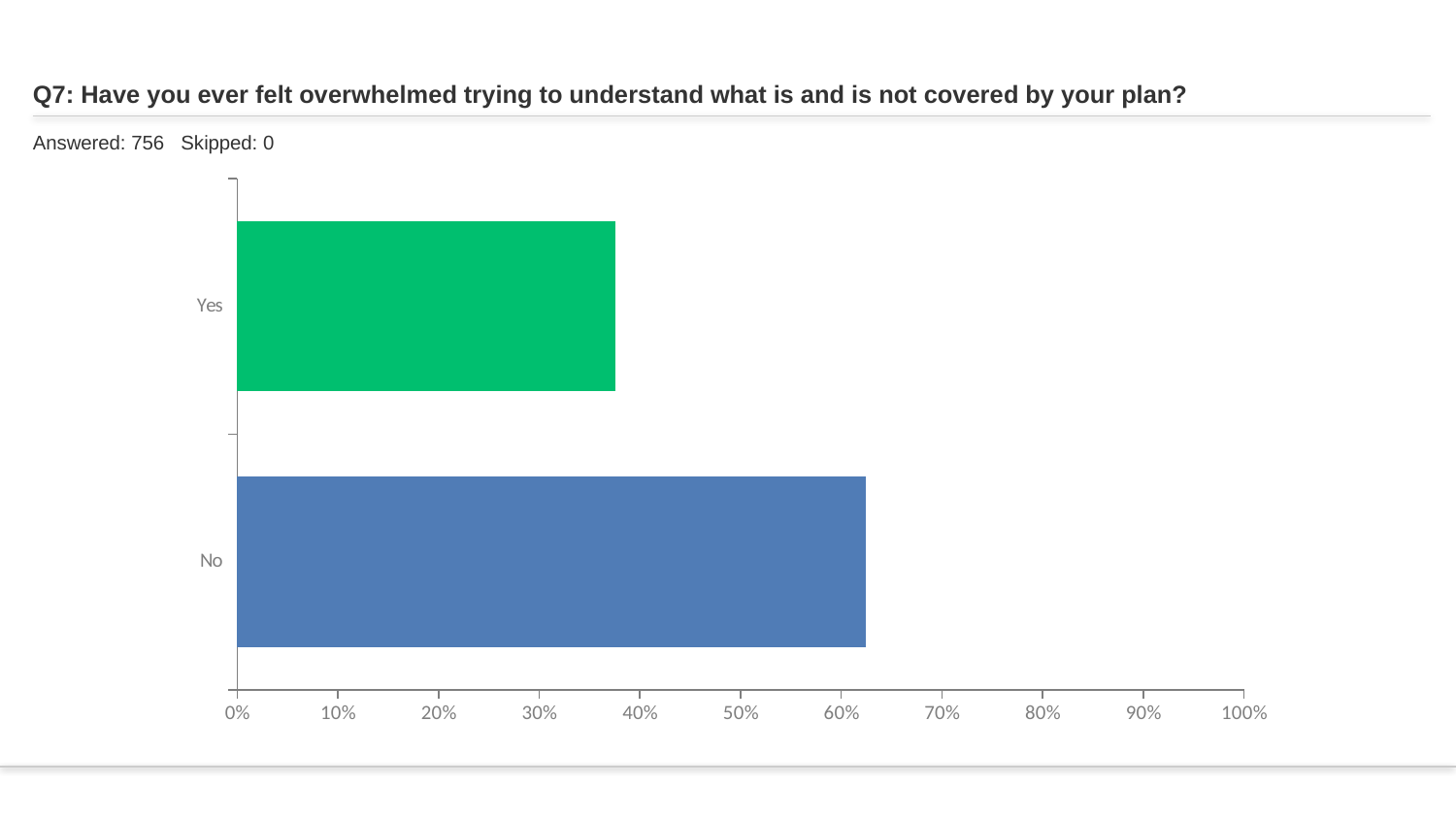
What kind of chart is shown on the slide? bar chart Which is larger, the value for Yes or the value for No? No What is the question number shown in the chart title? Q7 Which category has the lowest value in the chart? Yes Which category has the highest value in the chart? No Is the value for Yes greater or less than 40%? less Is the value for No greater or less than 70%? less Is the value for No greater or less than 60%? greater How many categories are plotted in the chart? 2 How many respondents answered the question according to the slide? 756